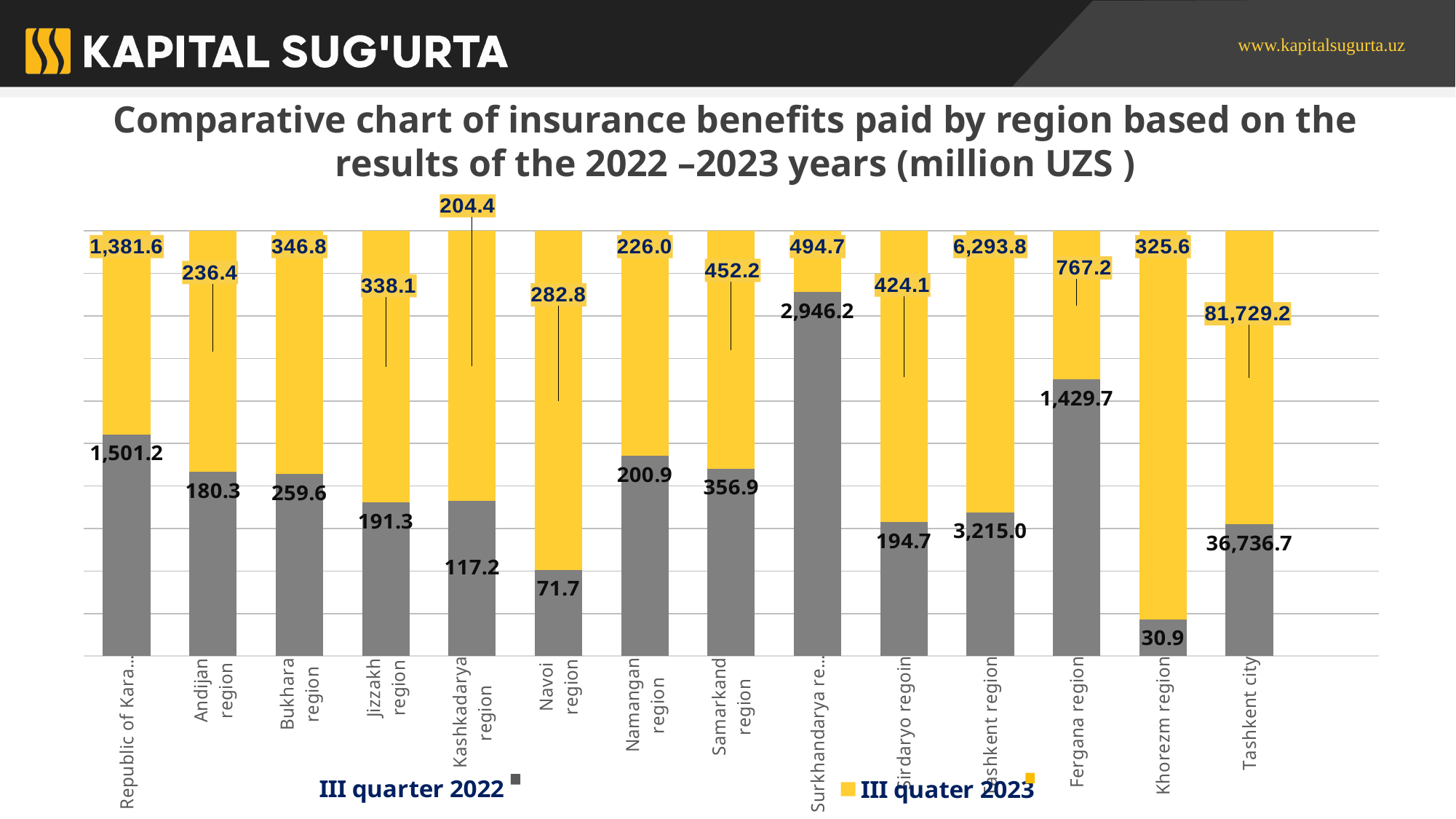
How many regions are shown on the x axis of the chart? 14 What is the III quater 2023 value for Tashkent region? 6,293.8 What is the difference between the III quater 2023 and III quarter 2022 values for Andijan region? 56.1 What is the III quarter 2022 value for Khorezm region? 30.9 Which region has the lowest III quarter 2022 value? Khorezm region What is the III quater 2023 value for Samarkand region? 452.2 How many series does the legend list? 2 Which region has the highest III quater 2023 value? Tashkent city For Fergana region, which is larger: the III quarter 2022 value or the III quater 2023 value? III quarter 2022 What is the difference between the III quater 2023 and III quarter 2022 values for Navoi region? 211.1 What kind of chart is shown on the slide? Stacked bar chart What is the III quarter 2022 value for Navoi region? 71.7